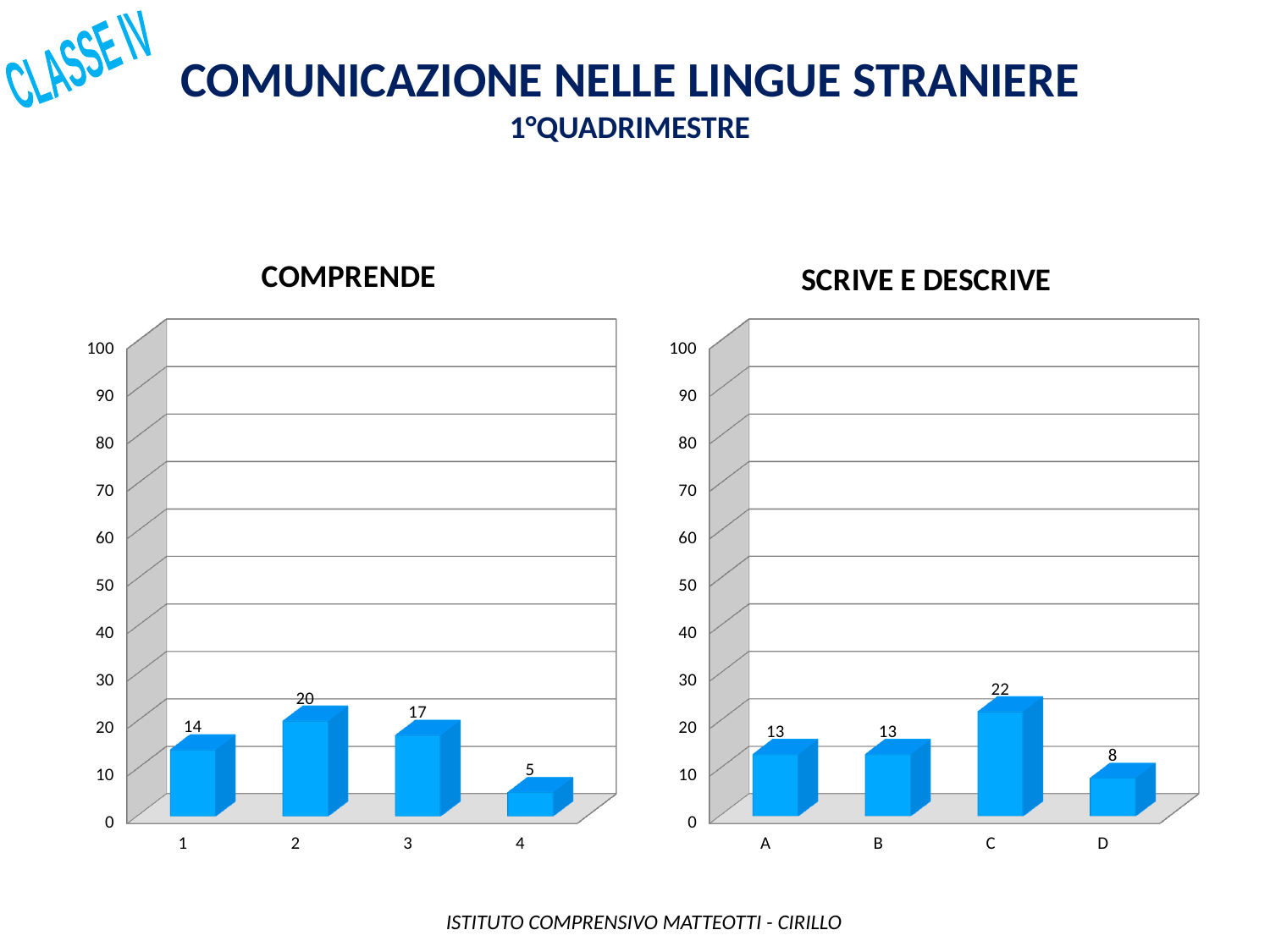
In the COMPRENDE chart, how many categories are shown on the x axis? 4 In the COMPRENDE chart, which category has the lowest value? 4 In the SCRIVE E DESCRIVE chart, which is larger, the value for A or the value for D? A In the COMPRENDE chart, what is the difference between the values for category 3 and category 4? 12 What is the title of the chart on the left of the slide? COMPRENDE In the SCRIVE E DESCRIVE chart, what is the value for category D? 8 What kind of chart is the SCRIVE E DESCRIVE chart? Bar chart In the COMPRENDE chart, what is the value for category 2? 20 In the SCRIVE E DESCRIVE chart, what is the difference between the values for C and B? 9 In the SCRIVE E DESCRIVE chart, which category has the highest value? C In the SCRIVE E DESCRIVE chart, what is the value for category C? 22 In the COMPRENDE chart, which category has the highest value? 2